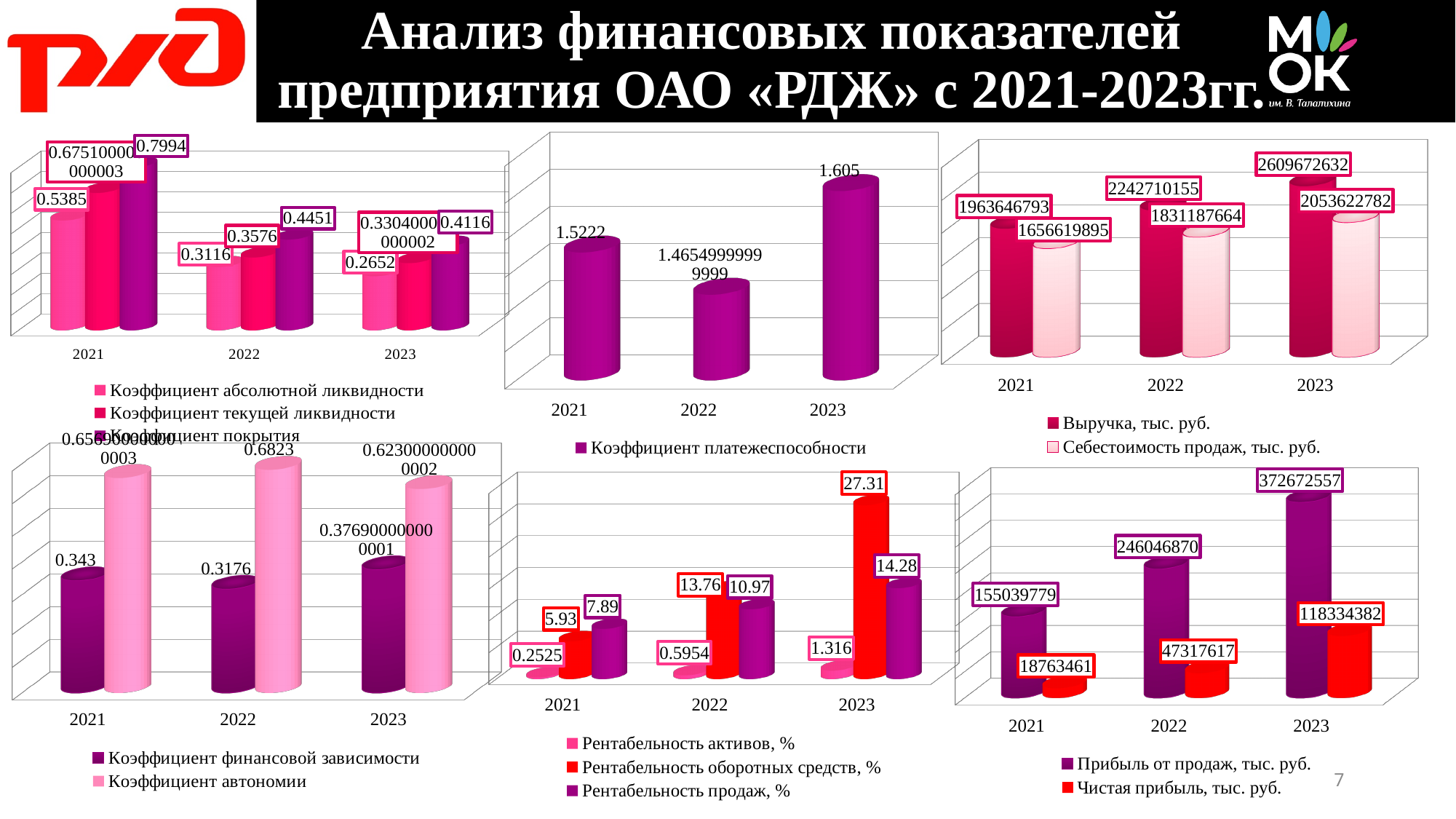
In the bottom-middle chart, what is the value of Рентабельность оборотных средств, % for 2023? 27.31 In the top-left chart, what is the value of Коэффициент абсолютной ликвидности for 2021? 0.5385 In the bottom-left chart, what is the value of Коэффициент автономии for 2022? 0.6823 In the top-right chart, what is the difference between Выручка and Себестоимость продаж for 2023? 556049850 In the bottom-middle chart, which is larger in 2022: Рентабельность оборотных средств or Рентабельность продаж? Рентабельность оборотных средств In the top-left chart, which year has the lowest value of Коэффициент покрытия? 2023 In the top-middle chart (Коэффициент платежеспособности), which year has the highest value? 2023 In the bottom-middle chart, how does Рентабельность активов change from 2021 to 2023? It rises In the top-right chart, what is the value of Выручка, тыс. руб. for 2022? 2242710155 In the top-middle chart (Коэффициент платежеспособности), what is the value for 2023? 1.605 In the bottom-right chart, what is the value of Чистая прибыль, тыс. руб. for 2021? 18763461 In the bottom-right chart, what is the difference between Прибыль от продаж and Чистая прибыль for 2022? 198729253